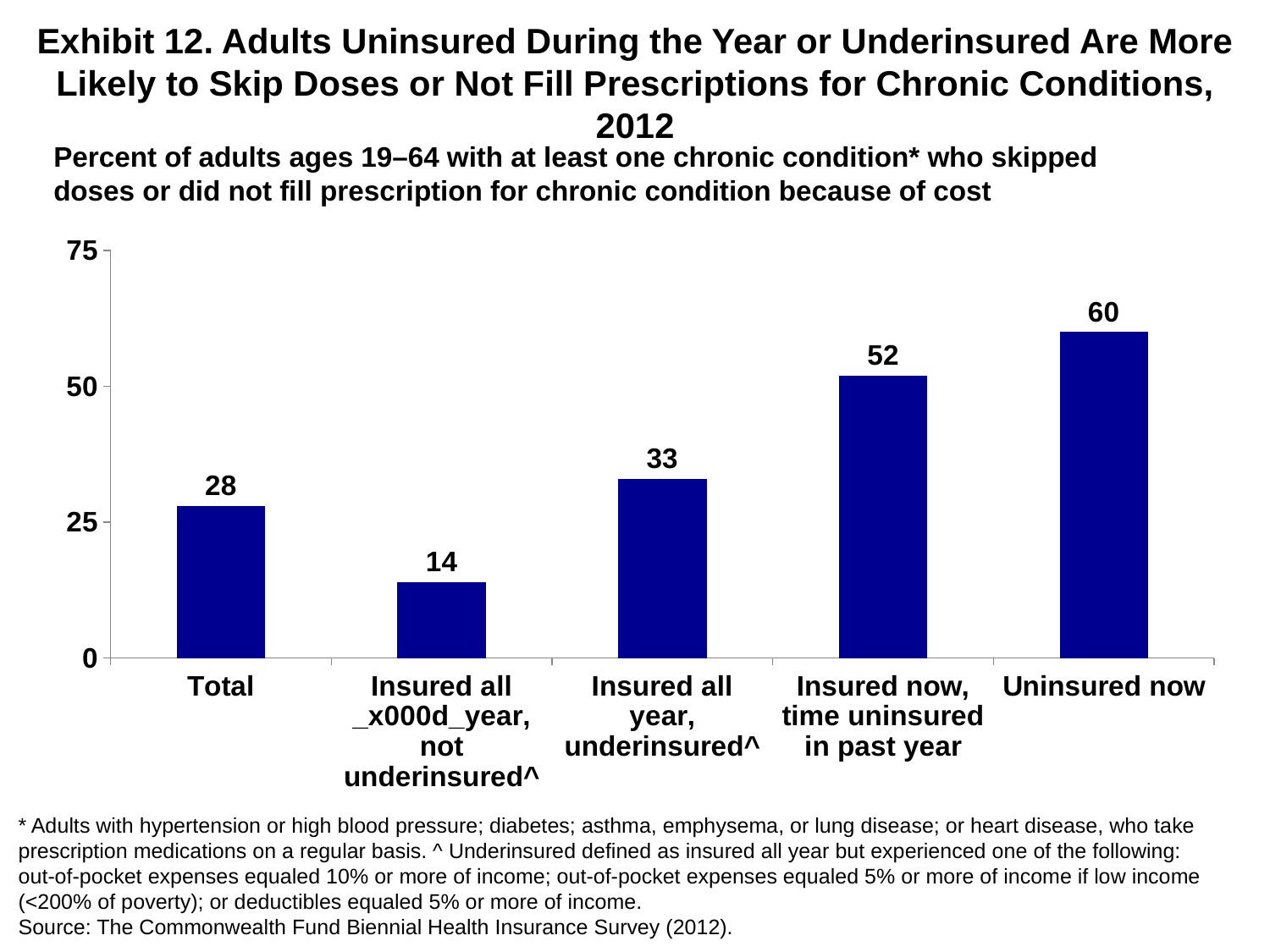
What is the value for Insured all year, underinsured^? 33 What is the value for Total? 28 What is the difference between the values for Uninsured now and Insured all year, not underinsured^? 46 What is the value for Insured now, time uninsured in past year? 52 How many categories are shown on the x axis? 5 What is the value for Uninsured now? 60 What is the difference between the values for Insured now, time uninsured in past year and Total? 24 Which category has the lowest value? Insured all year, not underinsured^ Which is larger, the value for Insured all year, underinsured^ or the value for Total? Insured all year, underinsured^ Is the value for Insured now, time uninsured in past year greater or less than 50? greater What kind of chart is shown on the slide? bar chart Which category has the highest value? Uninsured now